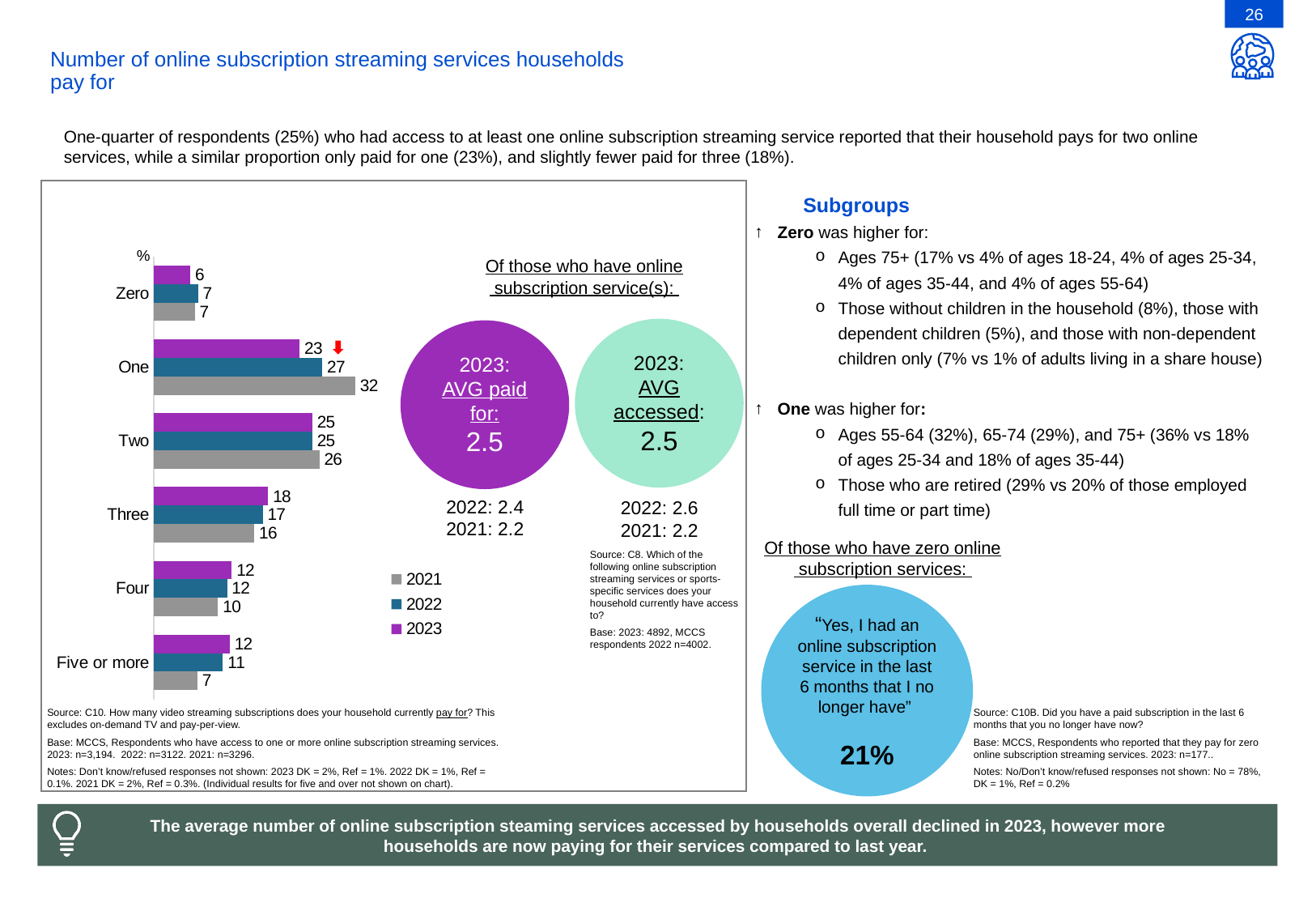
Which category had the highest value in 2023? Two What type of chart is used to show the number of online subscription streaming services households pay for? Bar chart Did the value for the 'One' category rise or fall from 2021 to 2023? Fall Which is larger for the 'Three' category: the 2023 value or the 2021 value? 2023 What was the 2021 value for households paying for one online subscription streaming service? 32 What is the difference between the 2021 and 2023 values for the 'One' category? 9 What percentage of households paid for two online subscription streaming services in 2023? 25 How many series does the chart legend list? 3 Which colour represents the 2023 series in the chart? Purple How many categories are shown on the bar chart? 6 Which category had the lowest value in 2021? Zero and Five or more (both 7) What was the 2022 value for the 'Five or more' category? 11